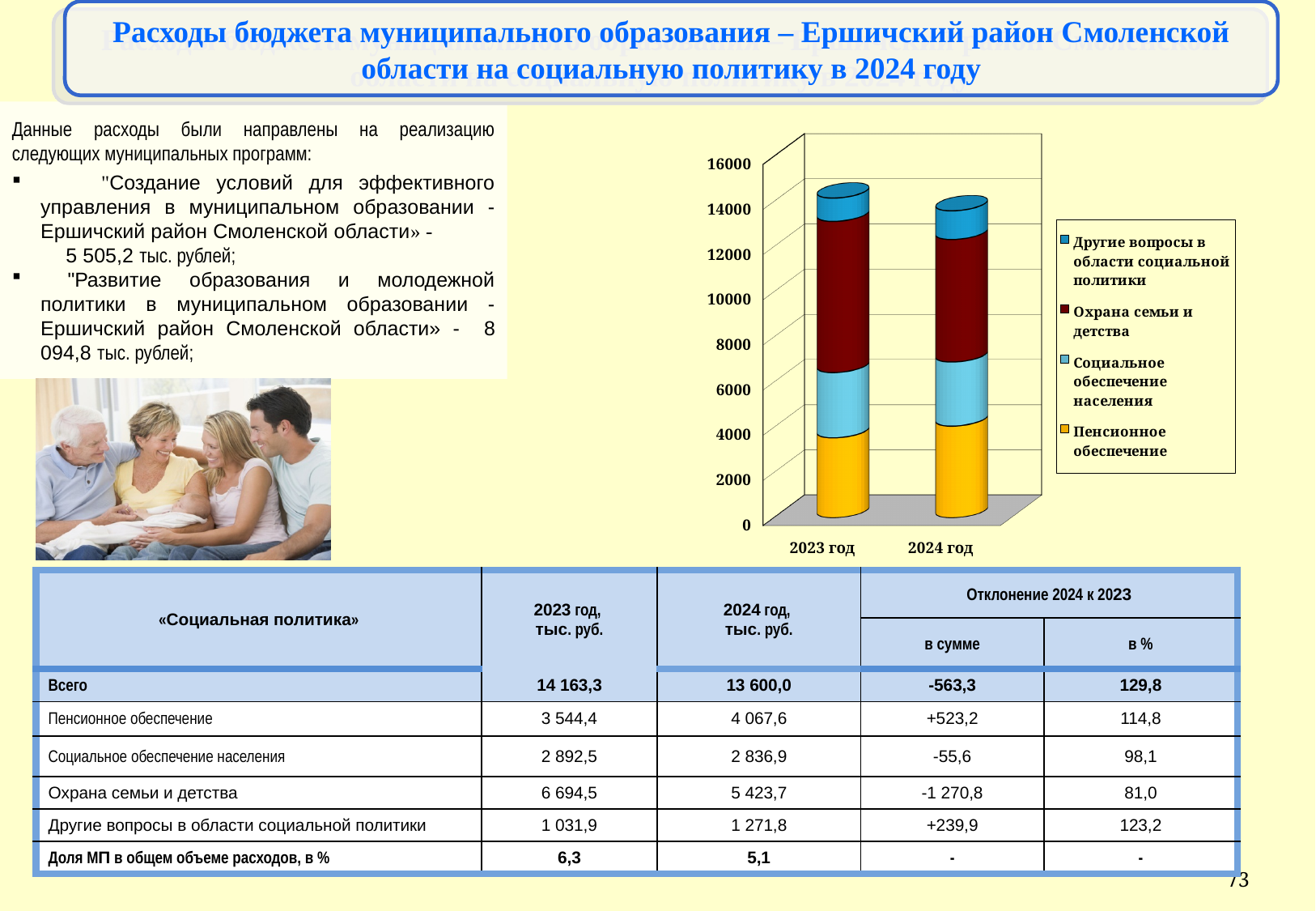
Which series is shown at the bottom of each stacked bar? Пенсионное обеспечение How many series does the chart legend list? 4 What is the highest value shown on the chart's vertical axis? 16000 Which year has the taller stacked bar in the chart, 2023 год or 2024 год? 2023 год Is the total height of the 2023 год bar greater or less than 16000? less Do the total bar heights rise or fall from 2023 год to 2024 год? fall Which series is drawn in dark red in the chart? Охрана семьи и детства How many categories (years) are plotted on the x axis of the chart? 2 What kind of chart is shown on the slide? stacked bar chart Is the total height of the 2024 год bar greater or less than 12000? greater